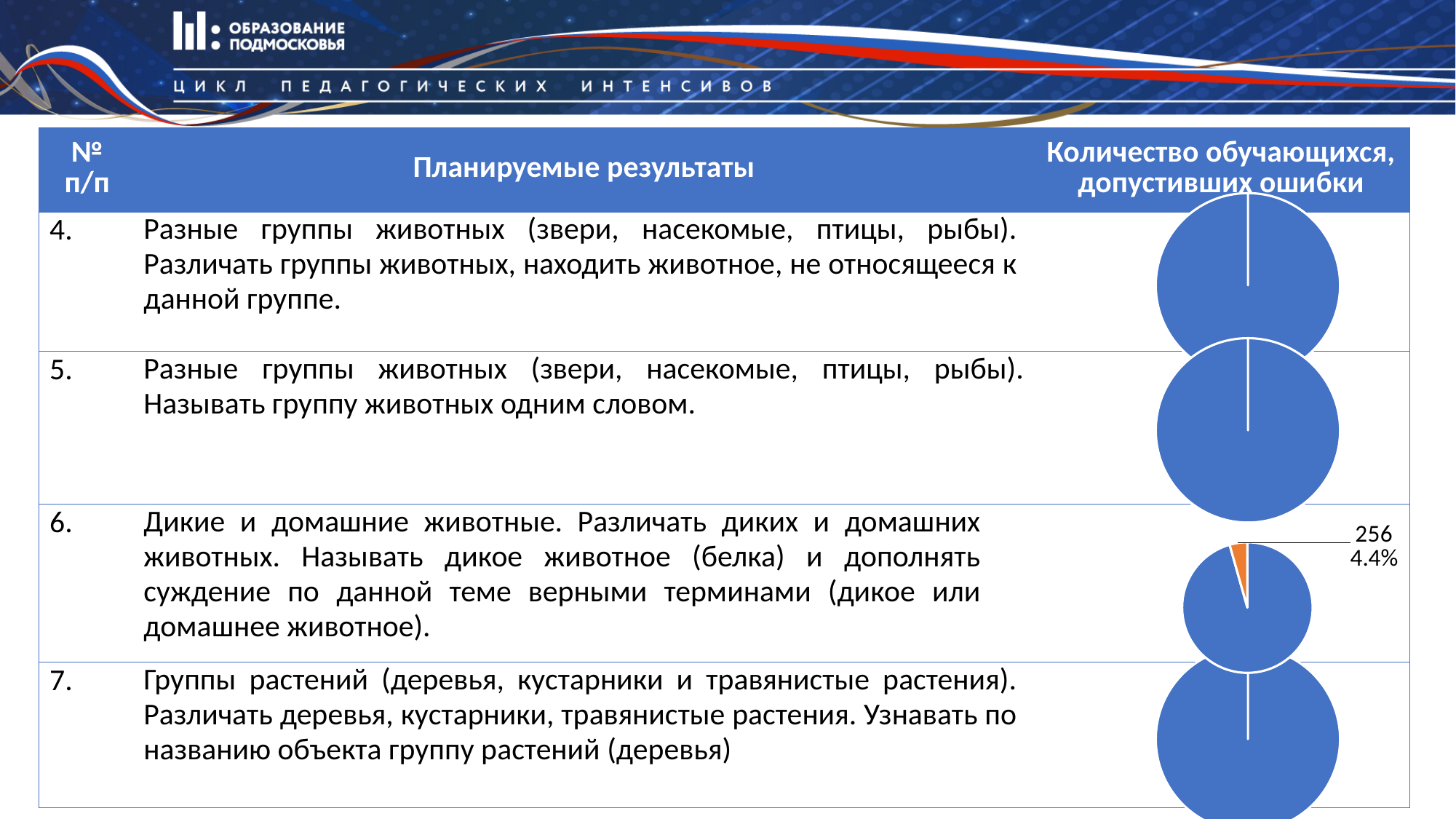
Which of the four pie charts is the only one with a printed data label? the pie chart for item 6 What colour is the dominant slice in each of the four pie charts? blue How many pie charts are shown in the right-hand column of the table? 4 In the pie chart for item 6, what percentage share is printed for the orange slice? 4.4% In the pie chart for item 6, what value is printed on the orange slice's data label? 256 In the pie chart for item 6, is the share of the orange slice greater or less than 50%? less What kind of chart is shown in the row for item 6? pie chart How many visibly distinct slices does the pie chart for item 6 have? 2 In the pie chart for item 6, which slice is larger, the blue one or the orange one? blue